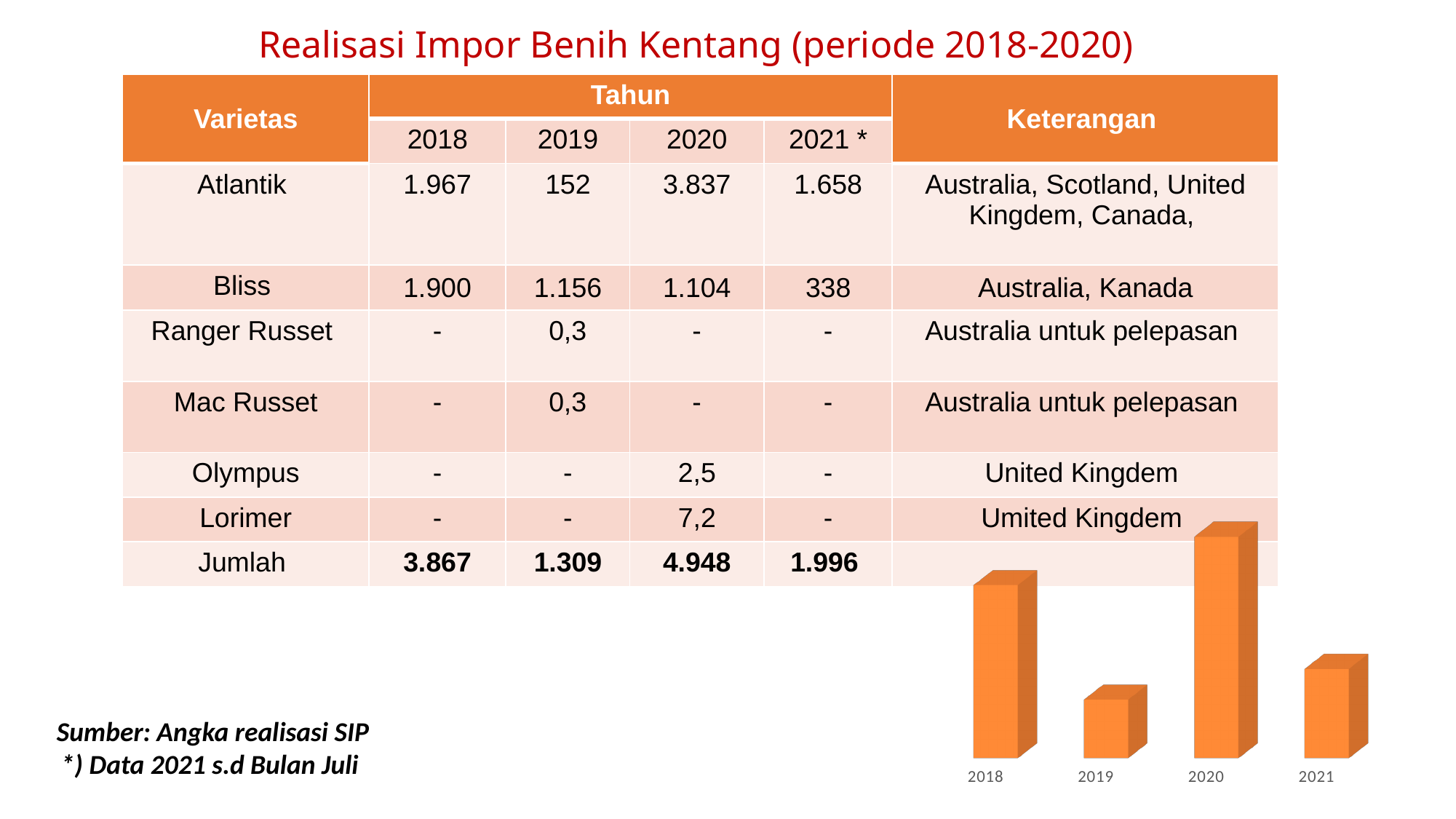
In the bar chart at the bottom right, does the bar height rise or fall from 2018 to 2019? fall In the bar chart at the bottom right, does the bar height rise or fall from 2020 to 2021? fall What colour are the bars in the chart at the bottom right of the slide? orange What labels appear along the x axis of the bar chart at the bottom right? 2018, 2019, 2020, 2021 How many bars does the chart at the bottom right of the slide have? 4 In the bar chart at the bottom right, which bar is taller, 2019 or 2021? 2021 In the bar chart at the bottom right, which bar is taller, 2018 or 2020? 2020 In the bar chart at the bottom right, which year has the tallest bar? 2020 In the bar chart at the bottom right, which bar is taller, 2018 or 2021? 2018 What kind of chart is shown at the bottom right of the slide? bar chart In the bar chart at the bottom right, which year has the shortest bar? 2019 In the bar chart at the bottom right, does the bar height rise or fall from 2019 to 2020? rise